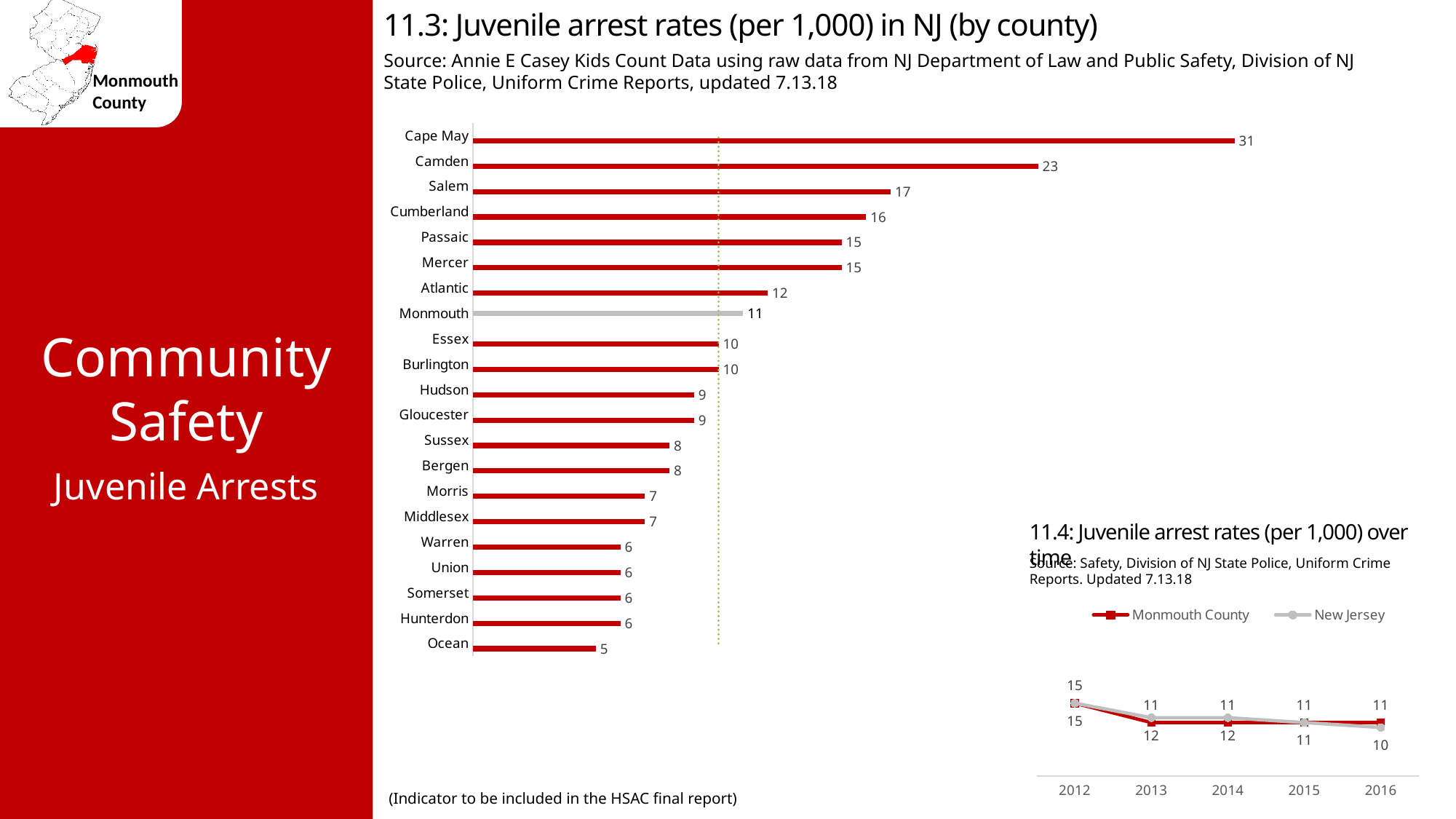
In chart 11.4 (juvenile arrest rates over time), how many series does the legend list? 2 What kind of chart is chart 11.4 (juvenile arrest rates over time)? Line chart In chart 11.3 (juvenile arrest rates by county), what is the difference between the values for Cape May and Camden? 8 In chart 11.3 (juvenile arrest rates by county), which county has the lowest juvenile arrest rate? Ocean In chart 11.3 (juvenile arrest rates by county), what is the value for Monmouth? 11 In chart 11.3 (juvenile arrest rates by county), how many counties are shown? 21 In chart 11.4 (juvenile arrest rates over time), do the values for Monmouth County rise or fall from 2012 to 2016? Fall In chart 11.3 (juvenile arrest rates by county), which county has the highest juvenile arrest rate? Cape May In chart 11.3 (juvenile arrest rates by county), which has a higher value, Salem or Atlantic? Salem In chart 11.4 (juvenile arrest rates over time), what is the value for Monmouth County in 2012? 15 In chart 11.3 (juvenile arrest rates by county), what is the value for Camden? 23 What kind of chart is chart 11.3 (juvenile arrest rates by county)? Bar chart